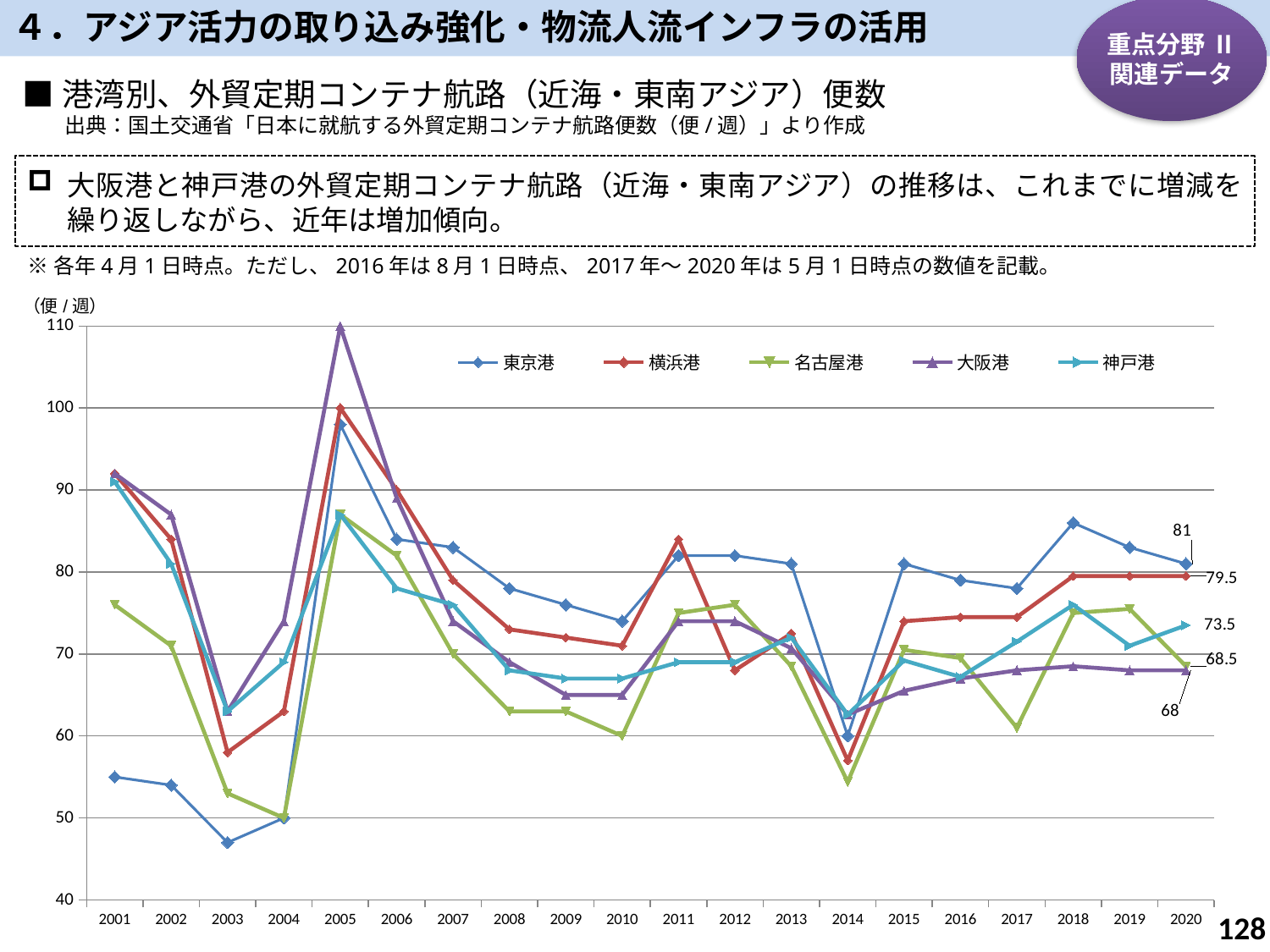
What is the value for 東京港 in 2020? 81 What is the value for 横浜港 in 2020? 79.5 What is the difference between the 2020 values for 東京港 and 横浜港? 1.5 What is the value for 大阪港 in 2020? 68 How many years are plotted along the x axis? 20 Which port has the highest value in 2020? 東京港 What unit is shown on the y axis label? 便/週 Is the value for 東京港 in 2003 greater or less than 50? less What is the value for 神戸港 in 2020? 73.5 Is the value for 大阪港 in 2005 greater or less than 100? greater What type of chart is shown on the slide? line chart How many series does the legend list? 5